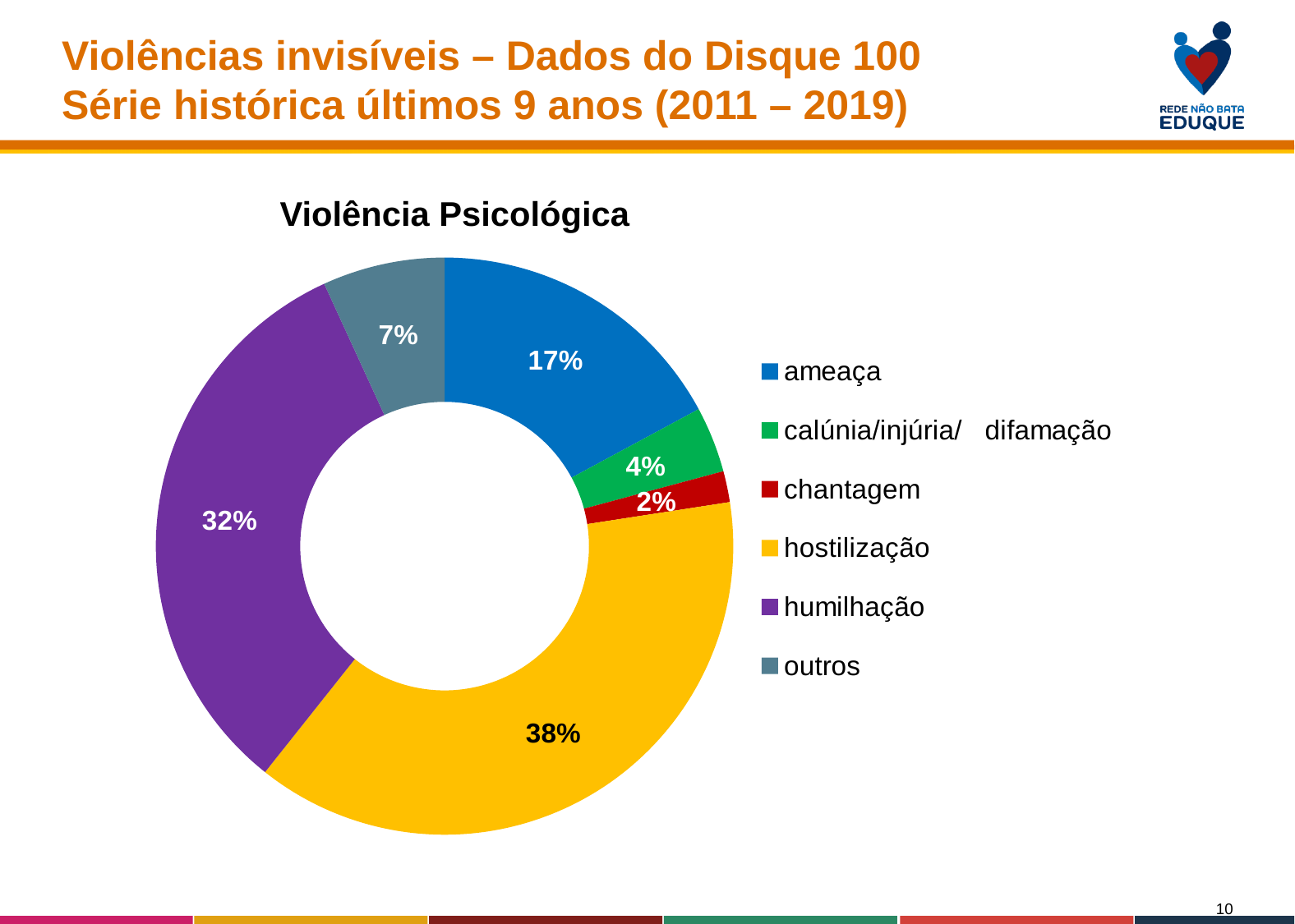
How many categories does the chart show? 6 What is the value for humilhação? 32% What is the difference between hostilização and humilhação? 6% What is the value for outros? 7% What is the value for chantagem? 2% What share of the pie does hostilização represent? 38% Which category has the smallest share? chantagem Which is larger, ameaça or outros? ameaça What is the value for ameaça? 17% Which category has the largest share? hostilização What kind of chart is shown? Pie chart (doughnut) What is the title of the chart? Violência Psicológica